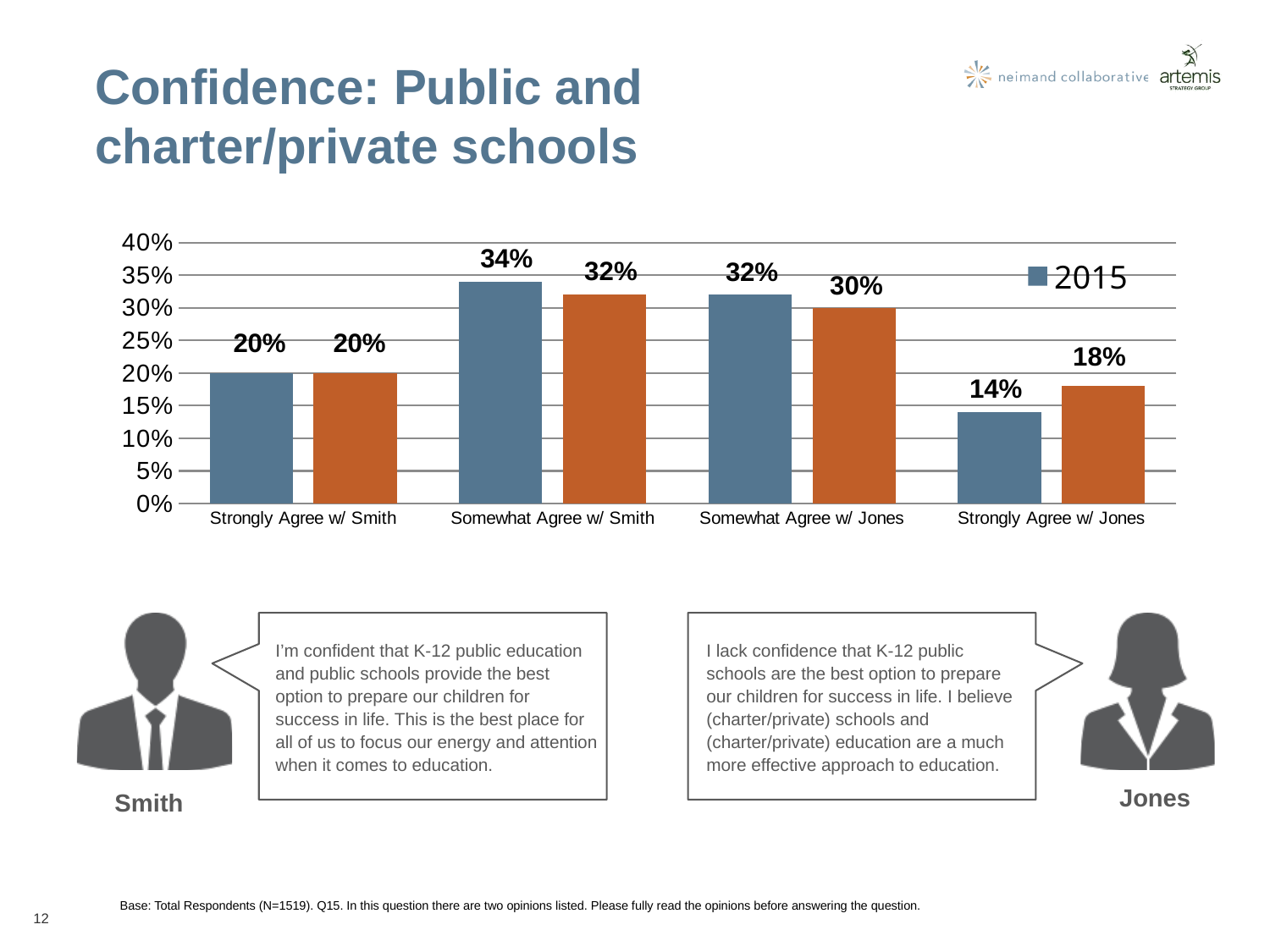
Which is larger, the 2015 value for Somewhat Agree w/ Smith or for Somewhat Agree w/ Jones? Somewhat Agree w/ Smith Which category has the highest 2015 value? Somewhat Agree w/ Smith What is the 2015 value for Strongly Agree w/ Jones? 14% How many categories are shown on the x axis? 4 Is the 2015 value for Strongly Agree w/ Jones greater or less than 15%? less What is the 2015 value for Strongly Agree w/ Smith? 20% What is the 2015 value for Somewhat Agree w/ Jones? 32% Which category has the lowest 2015 value? Strongly Agree w/ Jones What is the 2015 value for Somewhat Agree w/ Smith? 34% How many series does the legend list? 1 What kind of chart is shown on the slide? Bar chart What is the difference between the 2015 values for Somewhat Agree w/ Smith and Strongly Agree w/ Jones? 20%